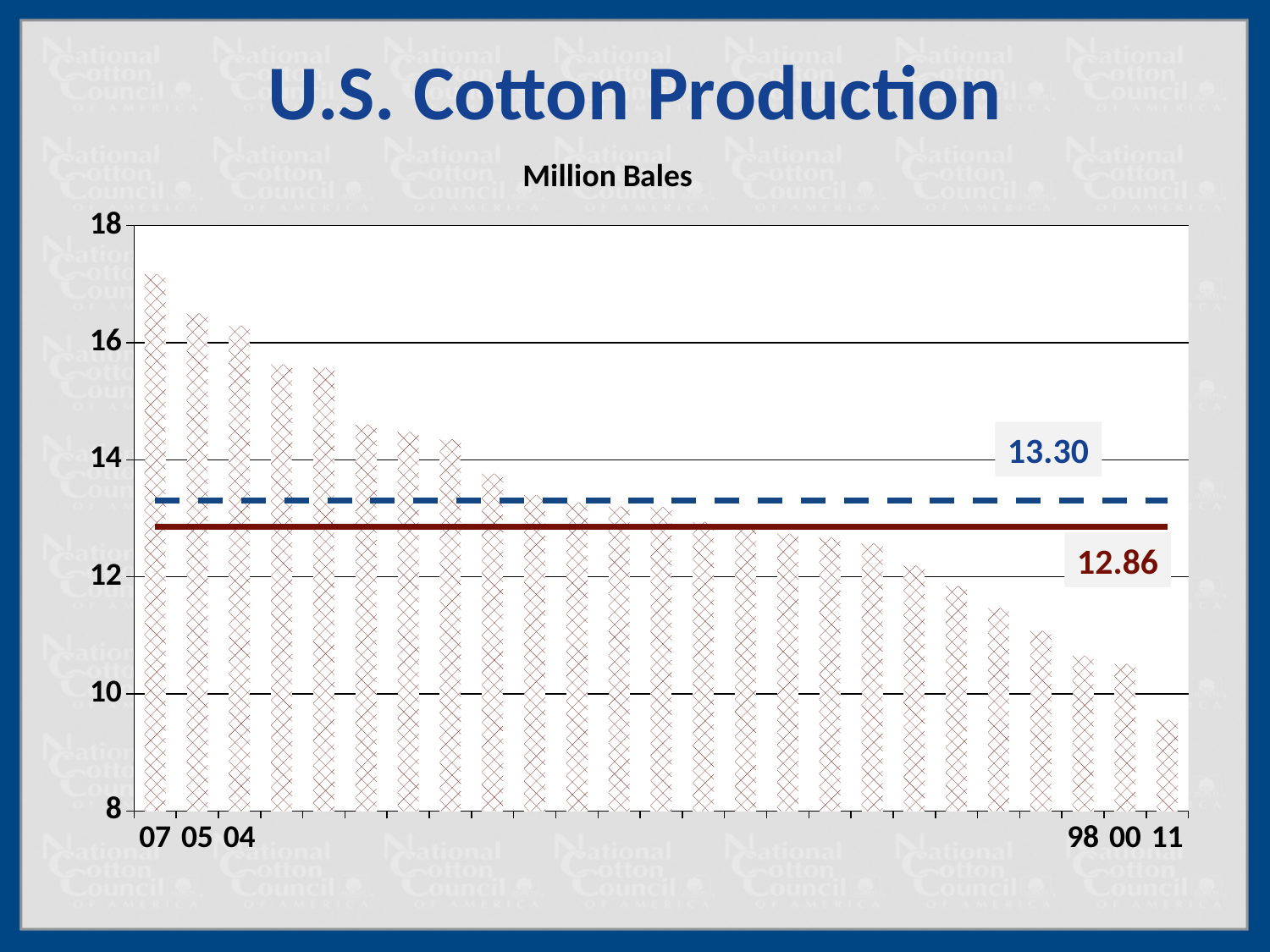
What value is labelled on the dashed blue horizontal line? 13.30 What is the title of the chart? U.S. Cotton Production What is the difference between the dashed line value (13.30) and the solid line value (12.86)? 0.44 What unit is the chart measured in, according to the label above the plot? Million Bales Is the value for 07 greater or less than 16? greater What value is labelled on the solid dark red horizontal line? 12.86 Which year has the lowest cotton production bar? 11 Do the bar values rise or fall moving from left to right along the x axis? fall What kind of chart is shown on the slide? bar chart Which year has the highest cotton production bar? 07 Which has the larger bar, 05 or 98? 05 Is the value for 11 greater or less than 10? less